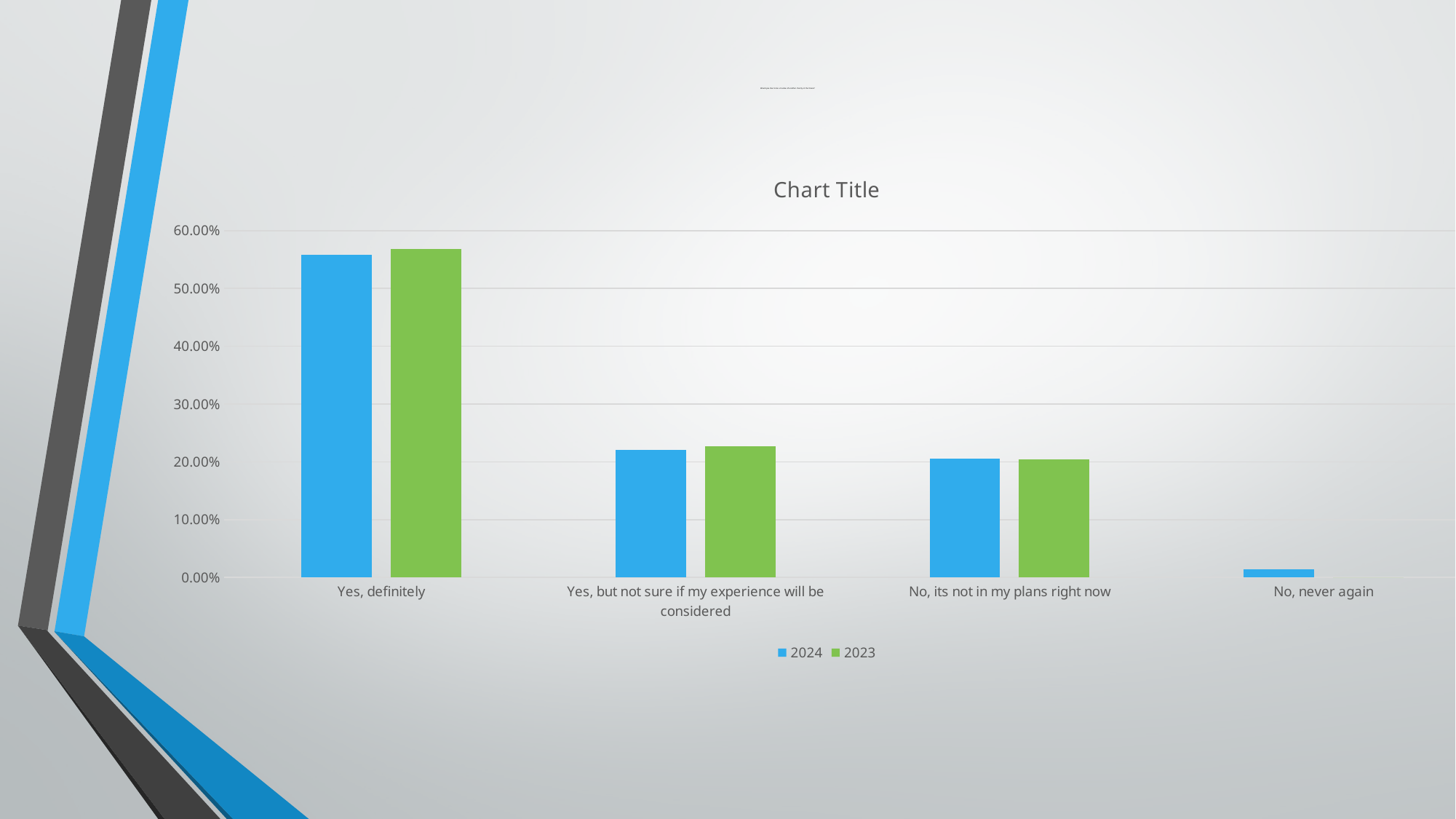
How many categories are shown on the x axis? 4 Is the 2024 value for "Yes, definitely" greater or less than 50.00%? greater What colour are the bars for the 2024 series? blue Is the 2023 value for "No, its not in my plans right now" greater or less than 30.00%? less Which category has the highest value for the 2024 series? Yes, definitely Is the 2024 value for "No, never again" greater or less than 10.00%? less Which category has the highest value for the 2023 series? Yes, definitely How many series does the legend list? 2 What kind of chart is shown on the slide? bar chart Which category has the lowest value for the 2024 series? No, never again Do the 2024 values rise or fall moving left to right along the x axis? fall